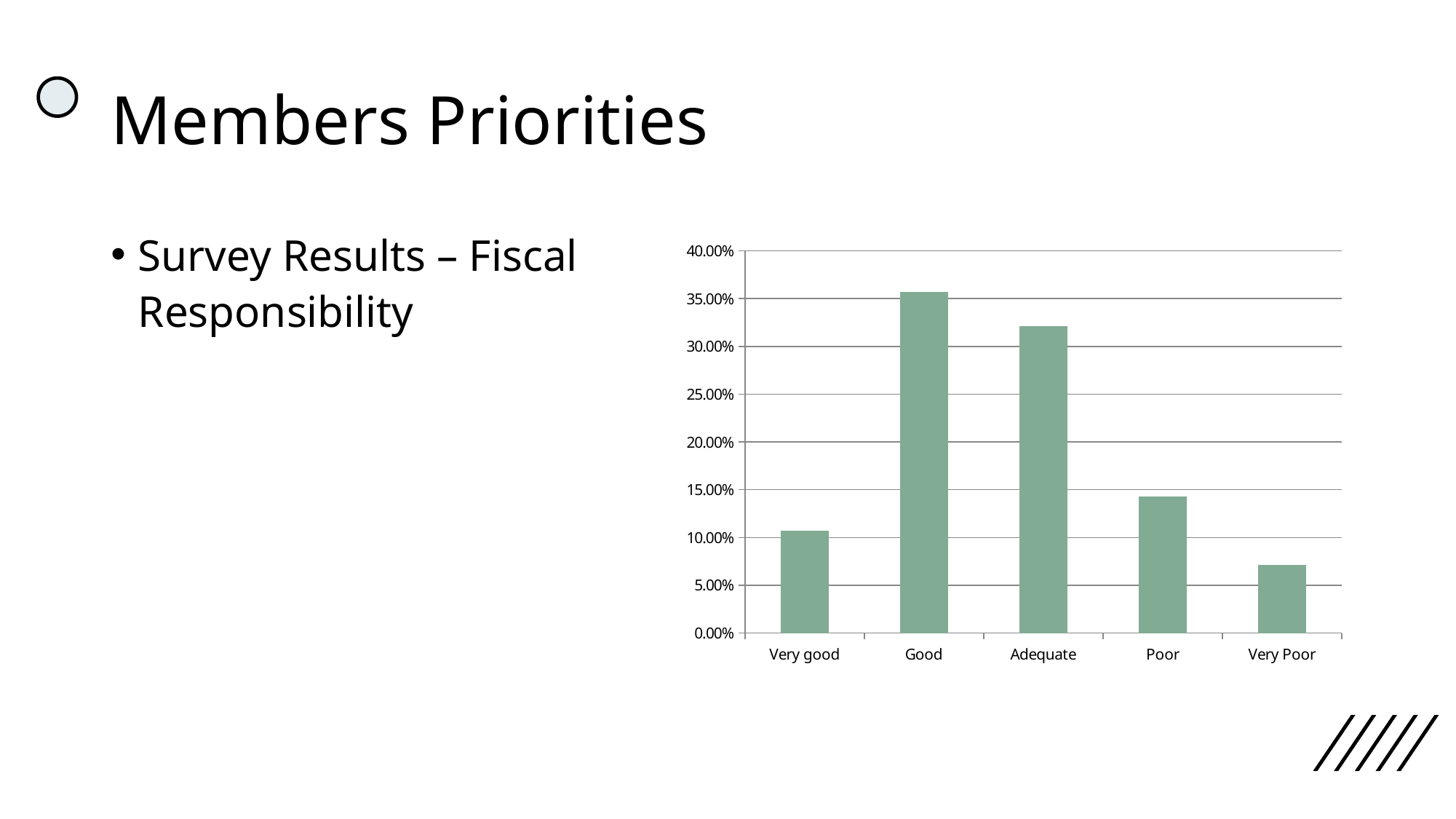
What kind of chart is shown on the slide? Bar chart Do the values rise or fall along the x axis from Adequate to Very Poor? fall Is the value for Poor greater or less than 10.00%? greater Which is larger, the value for Very good or the value for Poor? Poor Which category has the highest bar in the chart? Good Is the value for Adequate greater or less than 30.00%? greater Is the value for Very Poor greater or less than 10.00%? less Which category has the lowest bar in the chart? Very Poor Which is larger, the value for Good or the value for Adequate? Good How many categories are shown on the x axis of the chart? 5 What is the highest value shown on the chart's y axis? 40.00%